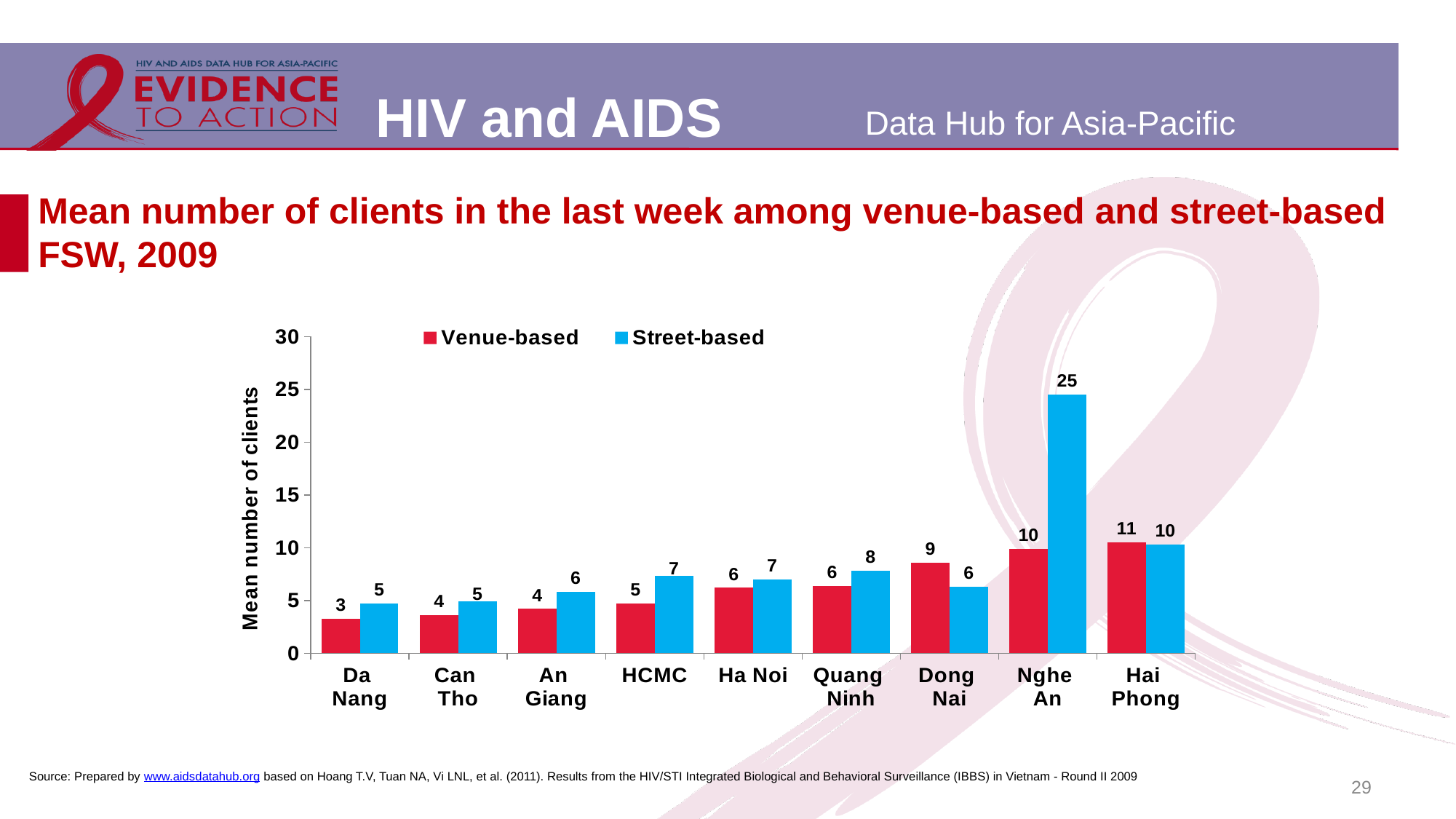
What is the mean number of clients for street-based FSW in Quang Ninh? 8 How many provinces are shown on the x axis of the chart? 9 Which province has the lowest mean number of clients among venue-based FSW? Da Nang What kind of chart is shown on the slide? Bar chart In Dong Nai, which group has the higher mean number of clients, venue-based or street-based? Venue-based What is the mean number of clients for venue-based FSW in Da Nang? 3 How many series does the legend list? 2 Which province has the highest mean number of clients among venue-based FSW? Hai Phong Which province has the highest mean number of clients among street-based FSW? Nghe An What is the mean number of clients for street-based FSW in Nghe An? 25 What is the mean number of clients for venue-based FSW in Hai Phong? 11 In Nghe An, what is the difference between the street-based and venue-based mean number of clients? 15